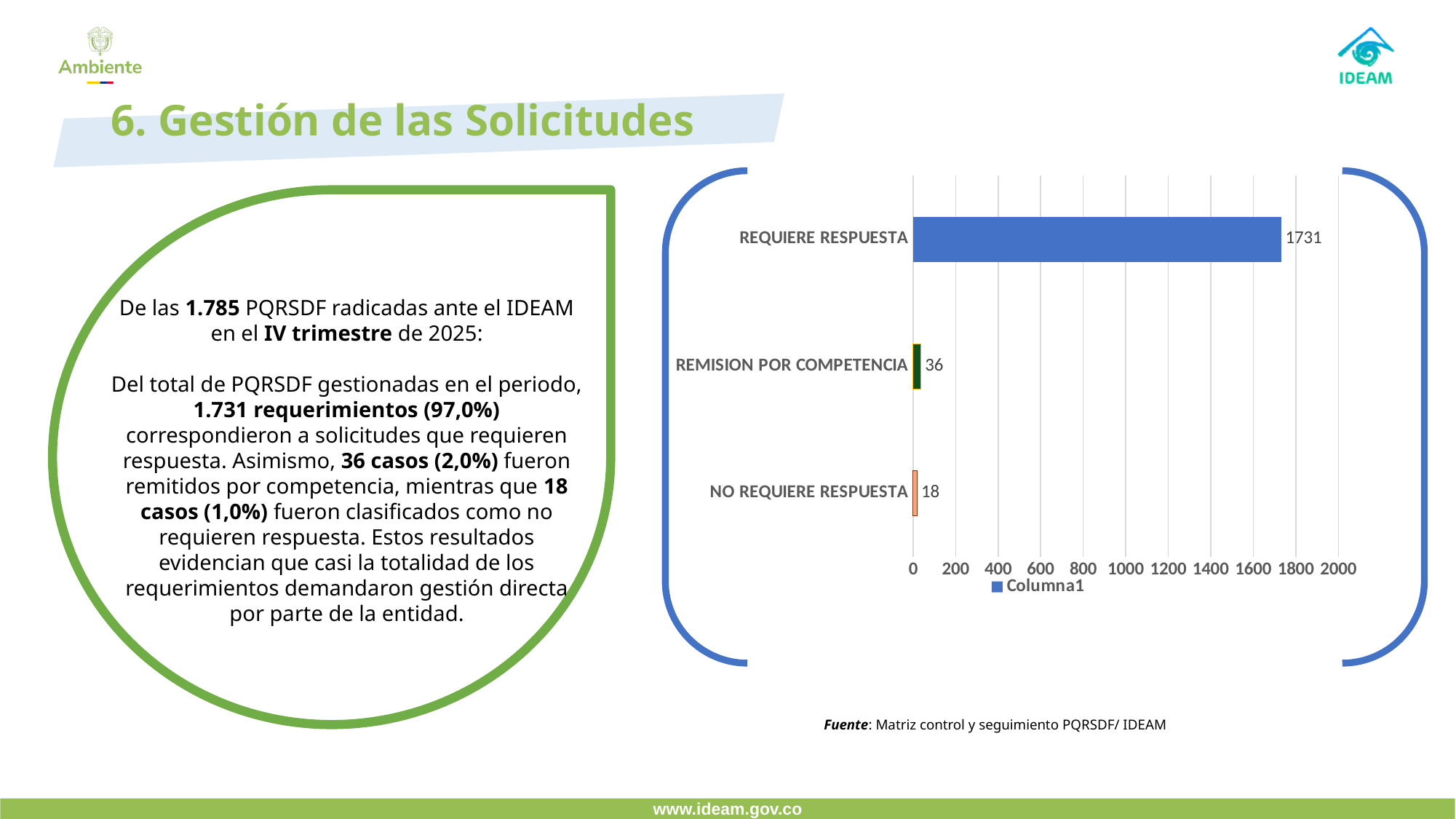
What is the legend entry shown below the chart? Columna1 What is the difference between the values for REMISION POR COMPETENCIA and NO REQUIERE RESPUESTA? 18 Which is larger, the value for REMISION POR COMPETENCIA or NO REQUIERE RESPUESTA? REMISION POR COMPETENCIA Which category has the lowest value? NO REQUIERE RESPUESTA Which category has the highest value? REQUIERE RESPUESTA What is the value for NO REQUIERE RESPUESTA? 18 What is the value for REQUIERE RESPUESTA? 1731 Is the value for REQUIERE RESPUESTA greater or less than 1600? greater What kind of chart is shown on the slide? bar chart What is the value for REMISION POR COMPETENCIA? 36 What is the difference between the values for REQUIERE RESPUESTA and REMISION POR COMPETENCIA? 1695 How many categories are shown in the chart? 3